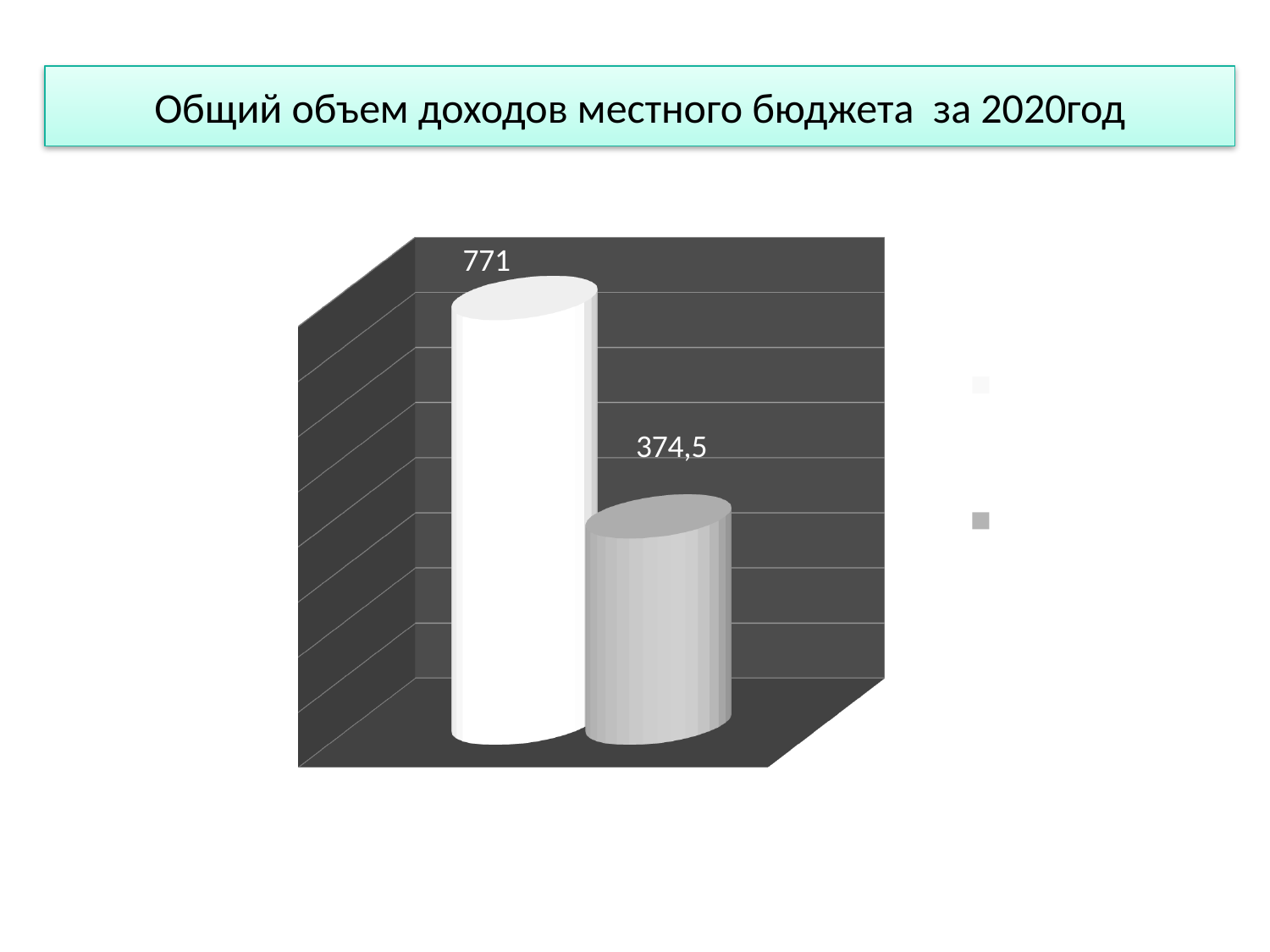
What is the highest value labelled on the chart? 771 What is the difference between the white bar's value and the grey bar's value? 396,5 How many bars are plotted in the chart? 2 What colour is the taller bar in the chart? white What is the value shown on the white bar in the chart? 771 Which bar has the higher value, the white bar or the grey bar? the white bar How many entries does the legend show? 2 What kind of chart is shown on the slide? bar chart What is the title of the slide? Общий объем доходов местного бюджета за 2020год What is the value shown on the grey bar in the chart? 374,5 What is the lowest value labelled on the chart? 374,5